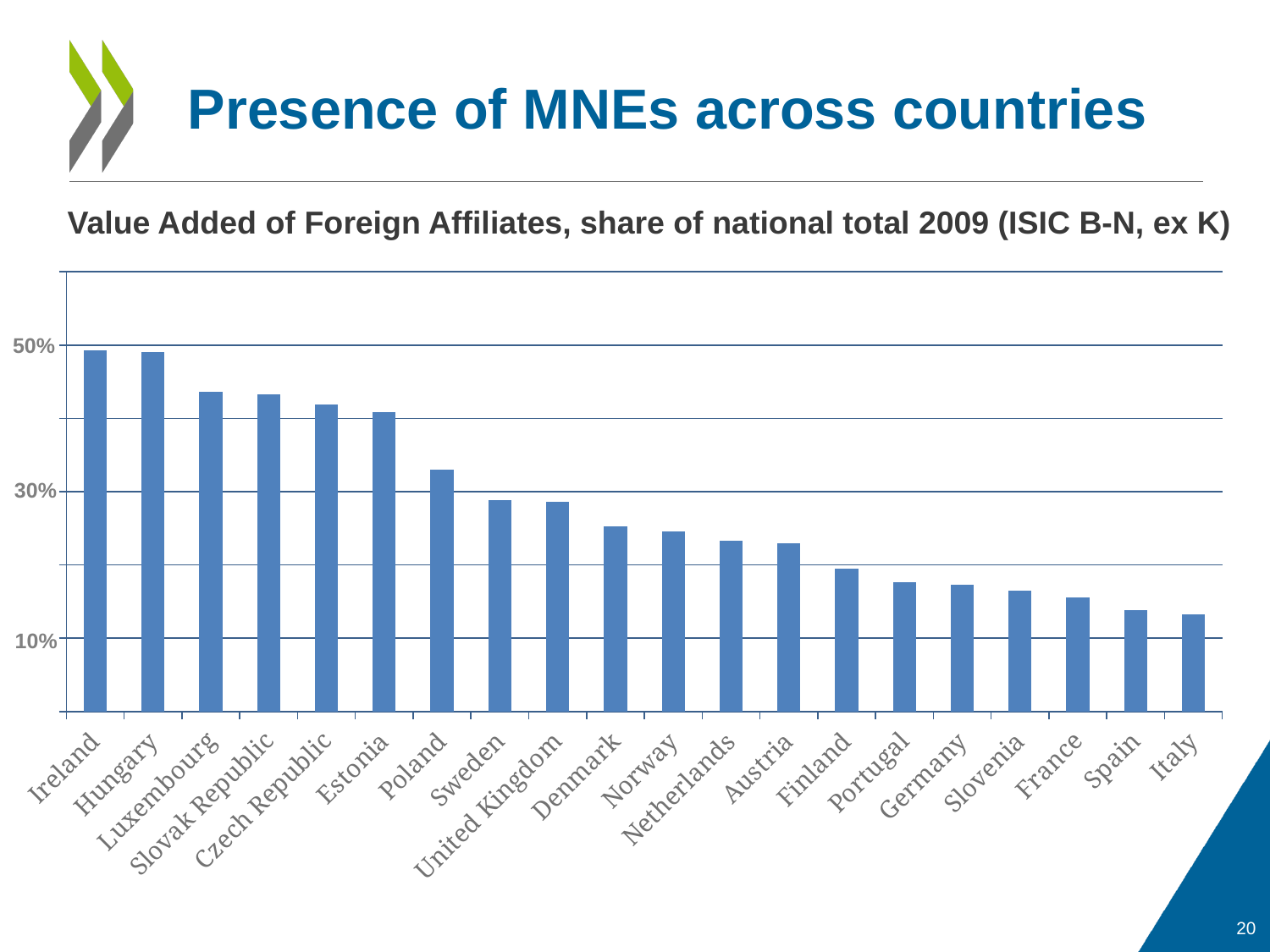
Which has the larger value, Finland or Spain? Finland Which has the larger value, Poland or Sweden? Poland Is the value for Italy greater or less than 10%? greater What is the title of the chart? Value Added of Foreign Affiliates, share of national total 2009 (ISIC B-N, ex K) How many countries are shown on the x axis of the chart? 20 Is the value for Poland greater or less than 30%? greater Do the values rise or fall moving from left to right along the x axis? fall Is the value for Estonia greater or less than 30%? greater What kind of chart is shown on the slide? bar chart Which has the larger value, Ireland or Italy? Ireland